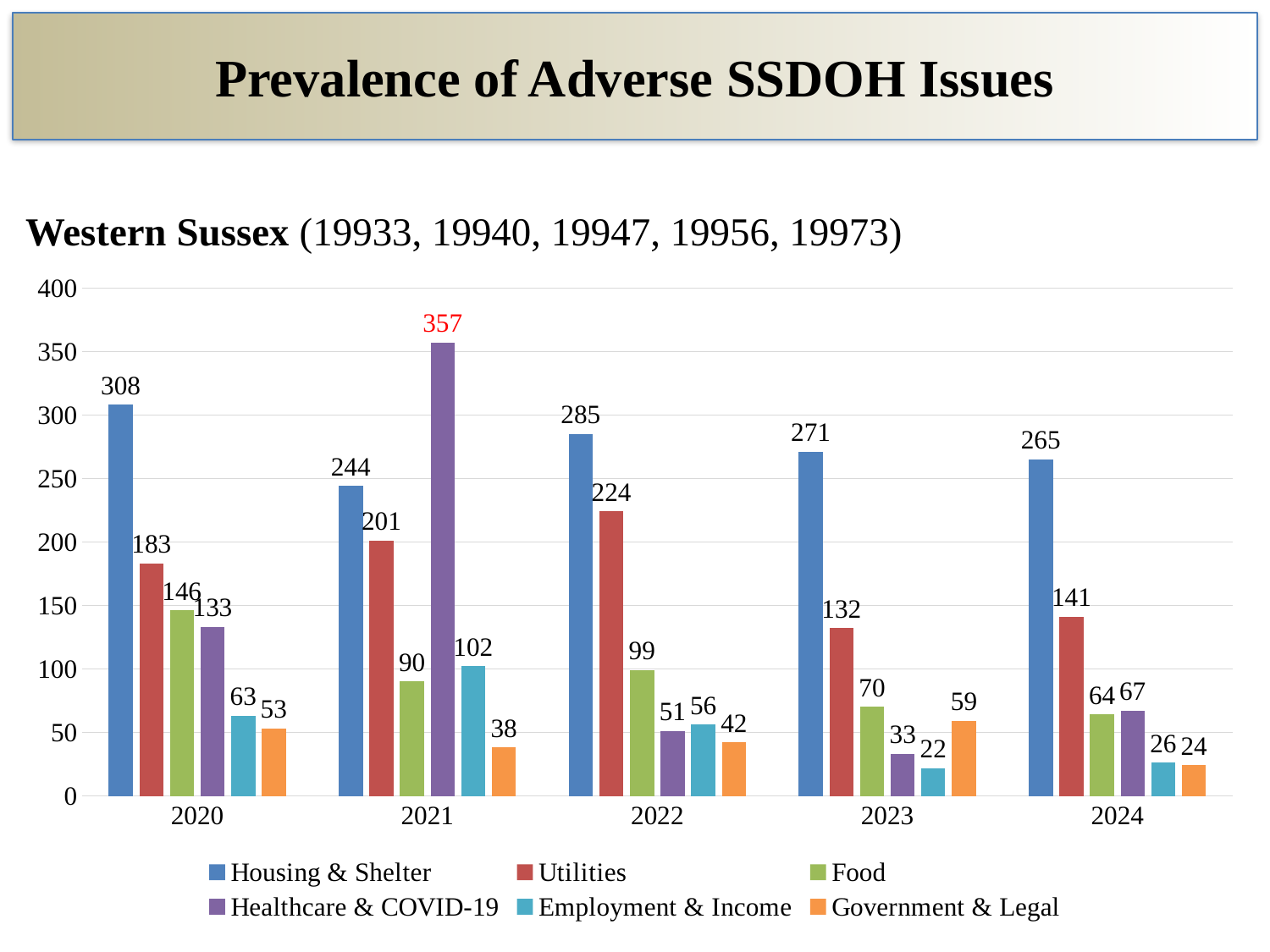
What is the value for Housing & Shelter in 2020? 308 Does the Employment & Income value rise or fall from 2021 to 2024? Fall How many series does the legend list? 6 What kind of chart is shown on the slide? Bar chart Which series has the lowest value in 2024? Government & Legal How many years are shown on the x axis? 5 What is the value for Utilities in 2022? 224 Which series has the highest value in 2021? Healthcare & COVID-19 What is the value for Healthcare & COVID-19 in 2021? 357 Which is larger: Food in 2020 or Food in 2022? Food in 2020 What is the difference between the Housing & Shelter values for 2020 and 2024? 43 What is the value for Employment & Income in 2023? 22